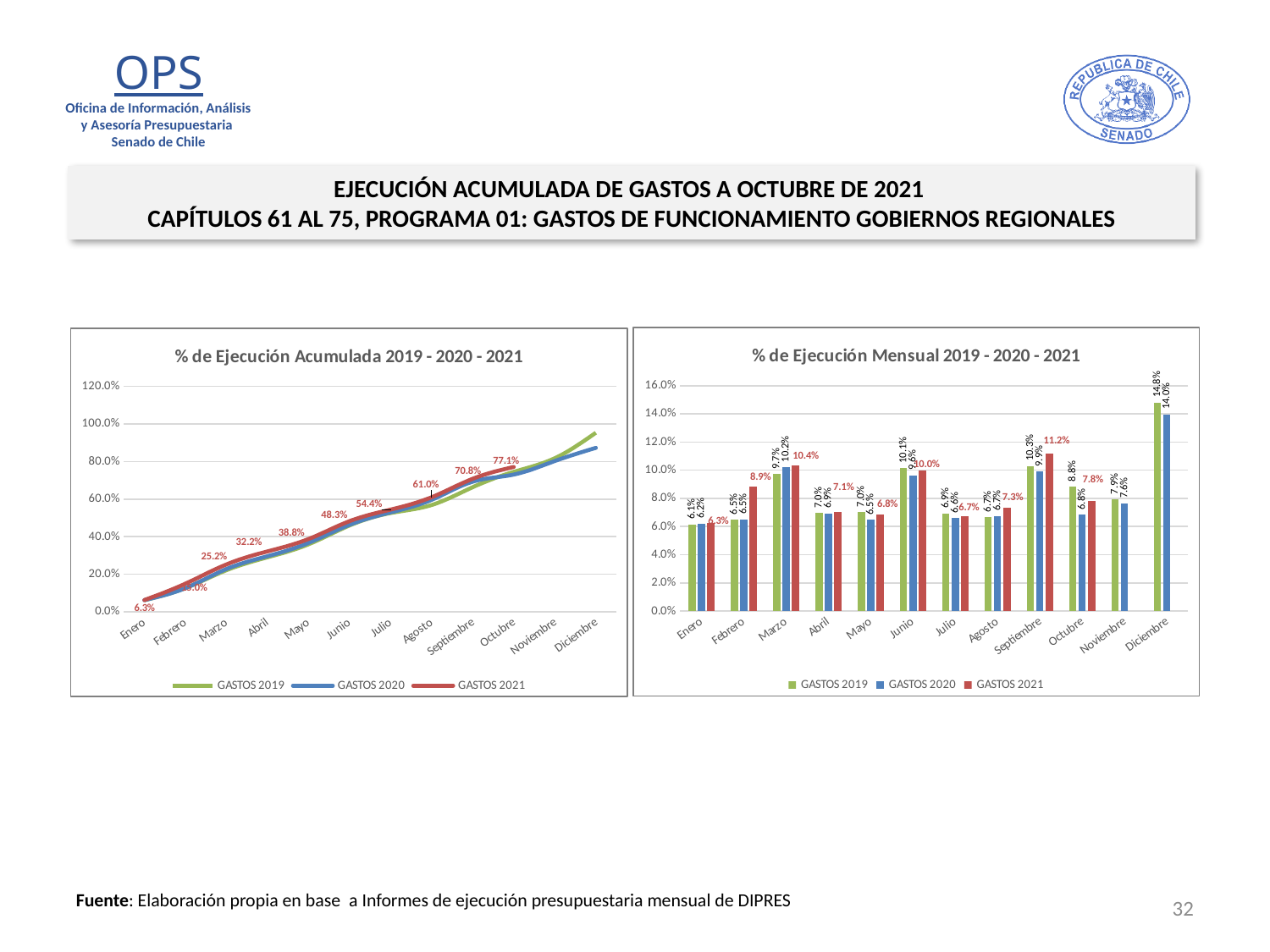
In the left chart '% de Ejecución Acumulada 2019 - 2020 - 2021', do the values rise or fall from Enero to Diciembre? Rise In the right chart '% de Ejecución Mensual 2019 - 2020 - 2021', which is larger for GASTOS 2021: Marzo or Febrero? Marzo What kind of chart is the right chart, '% de Ejecución Mensual 2019 - 2020 - 2021'? Bar chart In the right chart '% de Ejecución Mensual 2019 - 2020 - 2021', which month has the highest value for GASTOS 2019? Diciembre In the left chart '% de Ejecución Acumulada 2019 - 2020 - 2021', what is the value for GASTOS 2021 in Octubre? 77.1% In the left chart '% de Ejecución Acumulada 2019 - 2020 - 2021', what is the value for GASTOS 2021 in Junio? 48.3% How many series does the legend of the left chart '% de Ejecución Acumulada 2019 - 2020 - 2021' list? 3 In the left chart '% de Ejecución Acumulada 2019 - 2020 - 2021', what is the difference between the GASTOS 2021 values for Octubre and Septiembre? 6.3% How many months are shown on the x axis of the right chart '% de Ejecución Mensual 2019 - 2020 - 2021'? 12 What kind of chart is the left chart, '% de Ejecución Acumulada 2019 - 2020 - 2021'? Line chart In the left chart '% de Ejecución Acumulada 2019 - 2020 - 2021', is the value for GASTOS 2020 in Diciembre greater or less than 80.0%? greater In the right chart '% de Ejecución Mensual 2019 - 2020 - 2021', what is the value for GASTOS 2021 in Septiembre? 11.2%